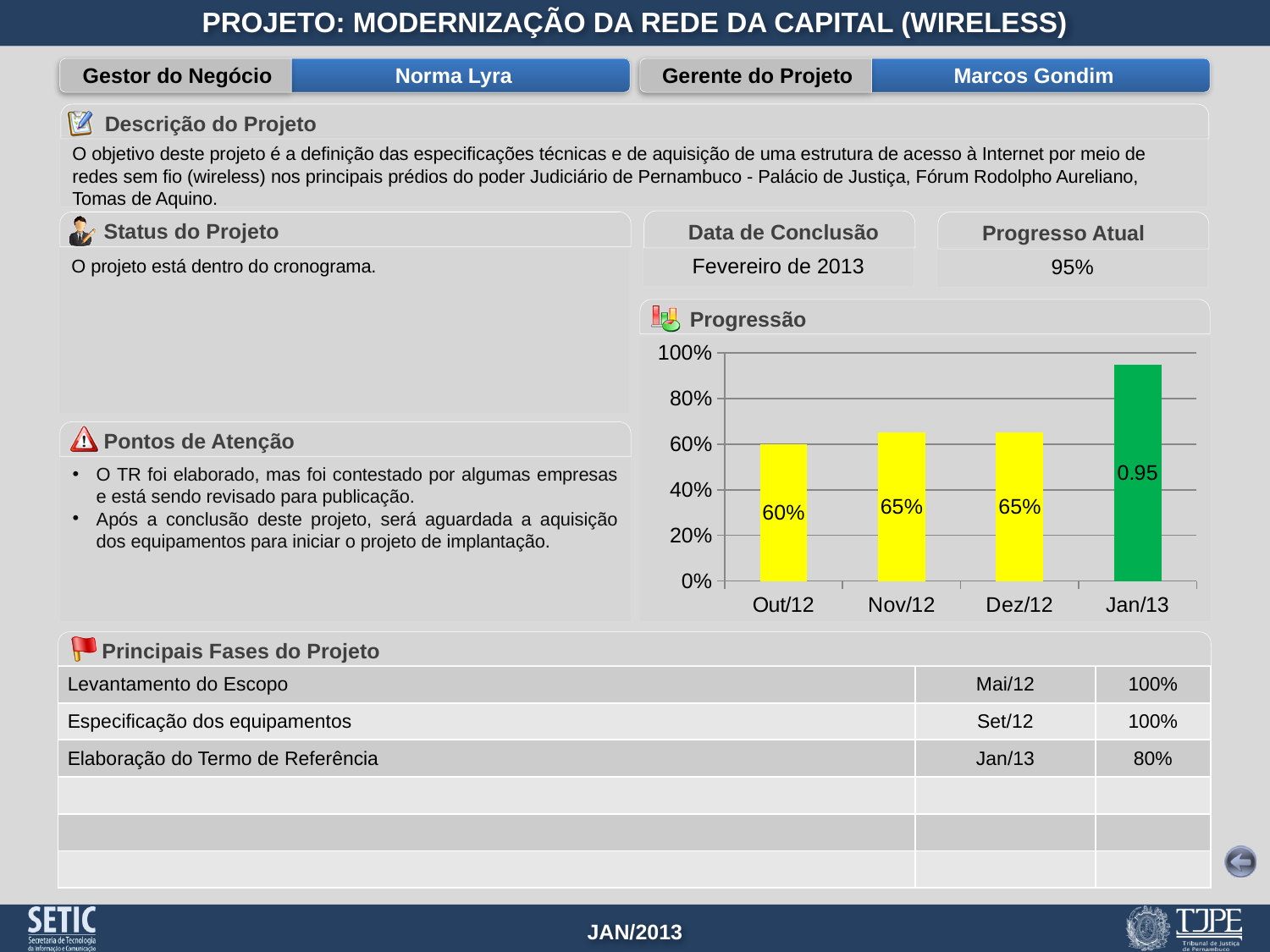
How many months are plotted in the Progressão chart? 4 In the Progressão chart, is the value for Jan/13 greater or less than 80%? greater In the Progressão chart, do the values generally rise or fall from Out/12 to Jan/13? rise In the Progressão chart, what data label is shown on the Jan/13 bar? 0.95 In the Progressão chart, what is the difference between the values for Nov/12 and Out/12? 5% In the Progressão chart, which month has the lowest value? Out/12 In the Progressão chart, which is larger, the value for Out/12 or the value for Dez/12? Dez/12 In the Progressão chart, which month has the highest value? Jan/13 What type of chart is shown under "Progressão"? bar chart In the Progressão chart, what is the value for Nov/12? 65% In the Progressão chart, what colour is the Jan/13 bar? green In the Progressão chart, what is the value for Out/12? 60%